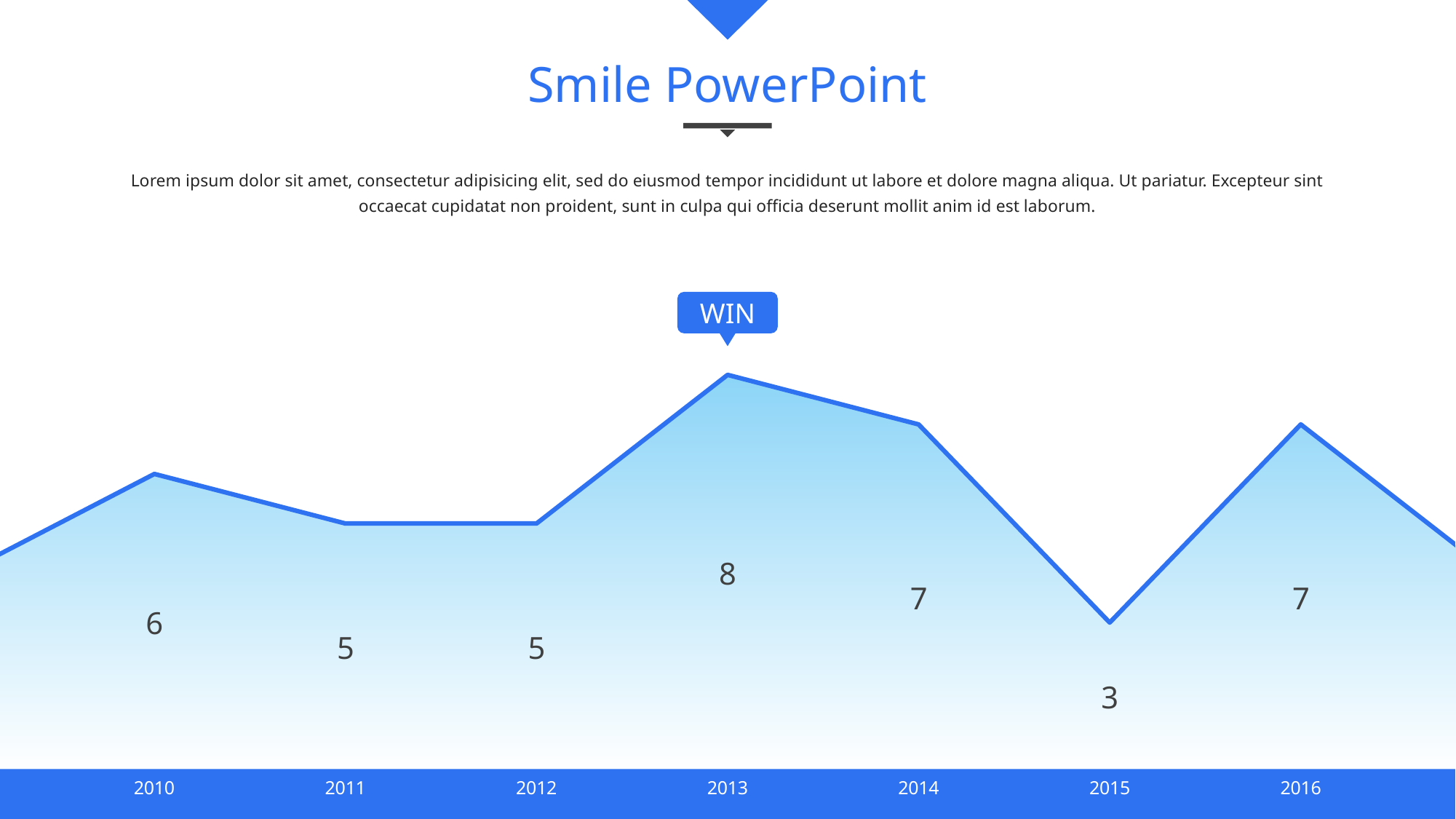
How many years are shown on the x axis? 7 What kind of chart is shown on the slide? Area chart What is the value for 2013? 8 Which year has the lowest value? 2015 What is the difference between the values for 2013 and 2015? 5 What is the value for 2015? 3 What is the value for 2014? 7 Which is larger, the value for 2014 or the value for 2015? 2014 What is the value for 2010? 6 Which year has the highest value? 2013 What is the difference between the values for 2010 and 2011? 1 Which year is marked with the "WIN" callout? 2013